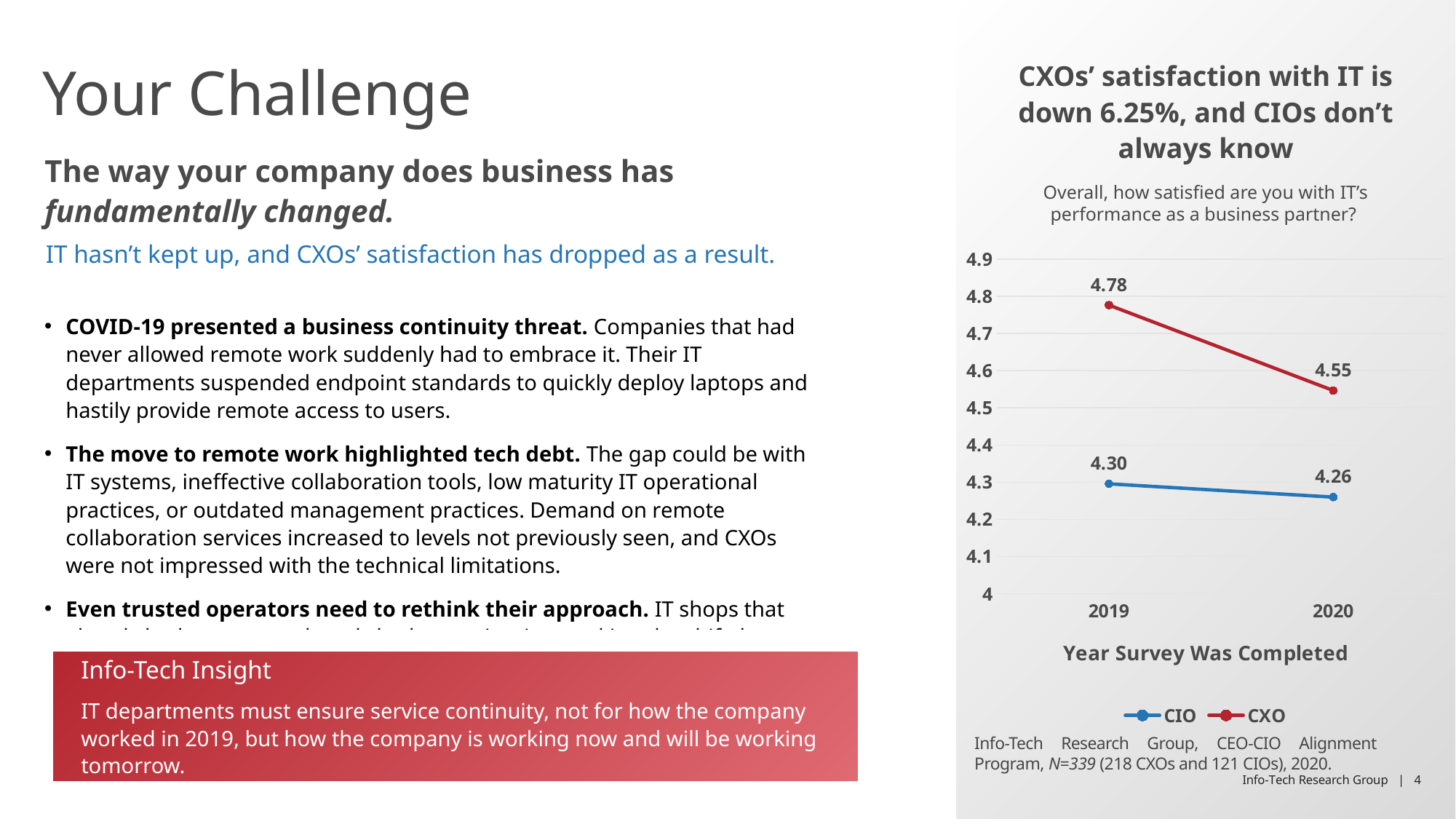
Which series has the higher value in 2019, CIO or CXO? CXO How many years are shown on the x axis? 2 How many series does the legend list? 2 By how much did the CXO value drop from 2019 to 2020? 0.23 What is the difference between the CXO and CIO values in 2020? 0.29 What is the CIO satisfaction value for 2019? 4.30 What is the CIO satisfaction value for 2020? 4.26 What kind of chart is shown on the slide? Line chart What is the x-axis title of the chart? Year Survey Was Completed What is the CXO satisfaction value for 2020? 4.55 What is the CXO satisfaction value for 2019? 4.78 Does the CXO series rise or fall from 2019 to 2020? Fall